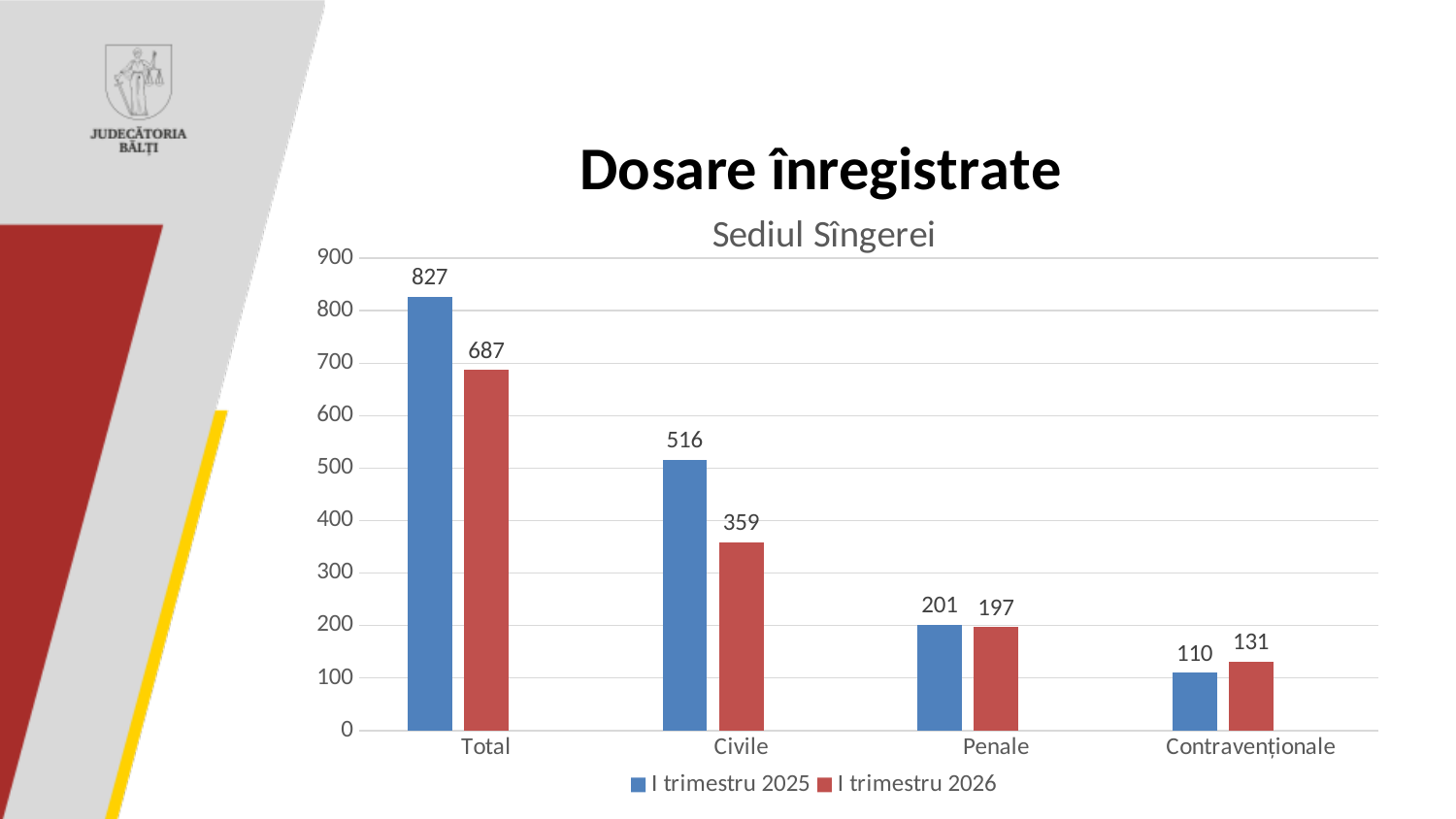
What is the difference between the I trimestru 2025 and I trimestru 2026 values for Total? 140 Which is larger for Contravenționale: the I trimestru 2025 value or the I trimestru 2026 value? I trimestru 2026 How many categories are shown on the x axis? 4 What is the value for Penale in the I trimestru 2026 series? 197 Which category has the highest value in the I trimestru 2025 series? Total What is the subtitle shown above the chart? Sediul Sîngerei What kind of chart is shown on the slide? Bar chart What is the difference between the I trimestru 2025 and I trimestru 2026 values for Civile? 157 What is the value for Civile in the I trimestru 2025 series? 516 Which category has the lowest value in the I trimestru 2026 series? Contravenționale What is the value for Contravenționale in the I trimestru 2026 series? 131 How many series does the legend list? 2